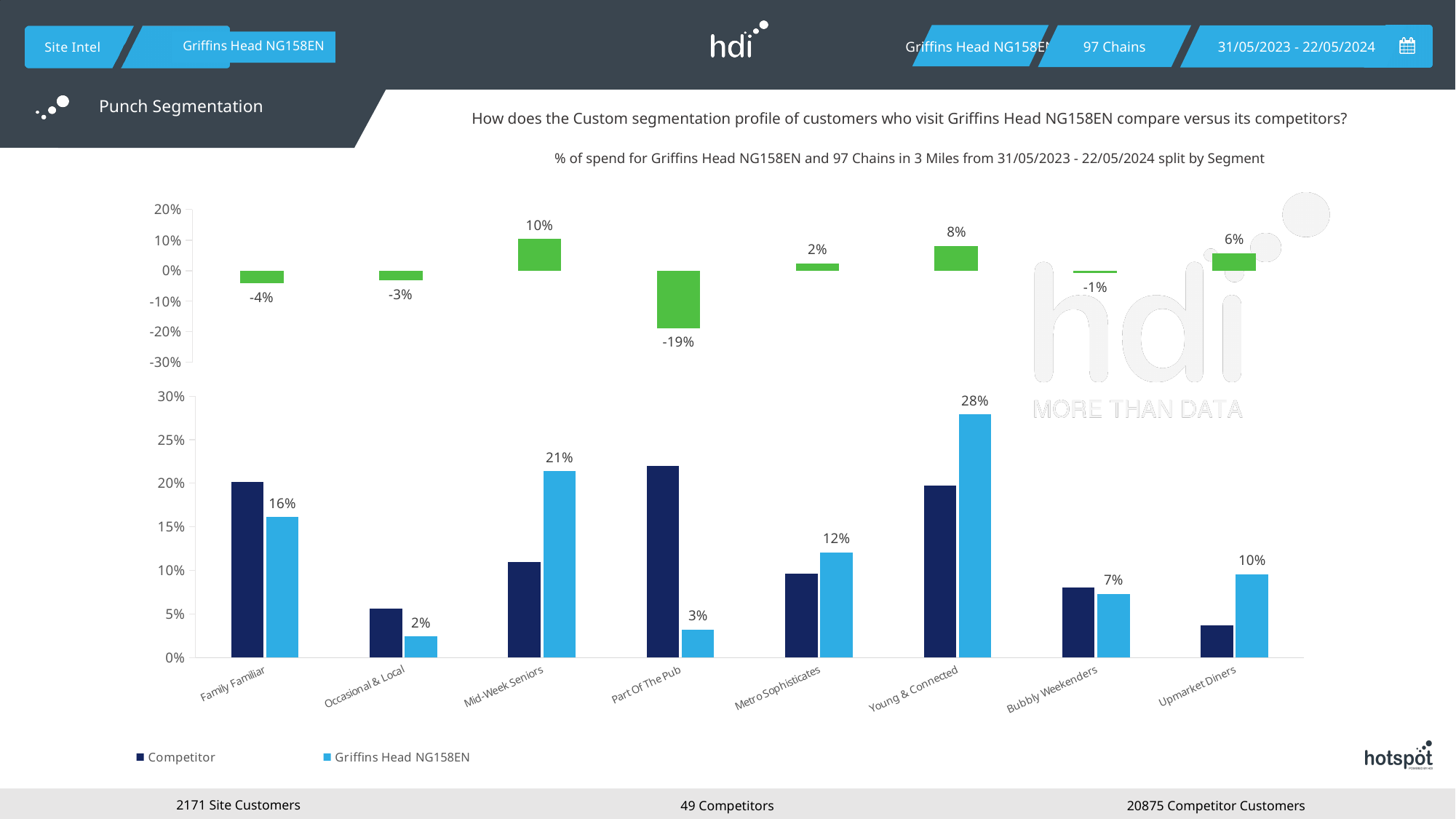
In the bottom chart, for Part Of The Pub, which series has the larger value: Competitor or Griffins Head NG158EN? Competitor In the top chart, what is the value shown for Part Of The Pub? -19% In the bottom chart, is the Competitor value for Family Familiar greater or less than 15%? greater How many series does the legend of the bottom chart list? 2 How many segments are shown on the x axis of the bottom chart? 8 What type of chart is the bottom chart? bar chart In the bottom chart, what is the difference between the Griffins Head NG158EN values for Young & Connected and Upmarket Diners? 18 percentage points In the bottom chart, which segment has the highest value for Griffins Head NG158EN? Young & Connected In the bottom chart, what is the value for Griffins Head NG158EN in the Young & Connected segment? 28% In the top chart, which segment has the lowest value? Part Of The Pub In the bottom chart, for Mid-Week Seniors, which series has the larger value: Competitor or Griffins Head NG158EN? Griffins Head NG158EN In the top chart, which segment has the highest value? Mid-Week Seniors